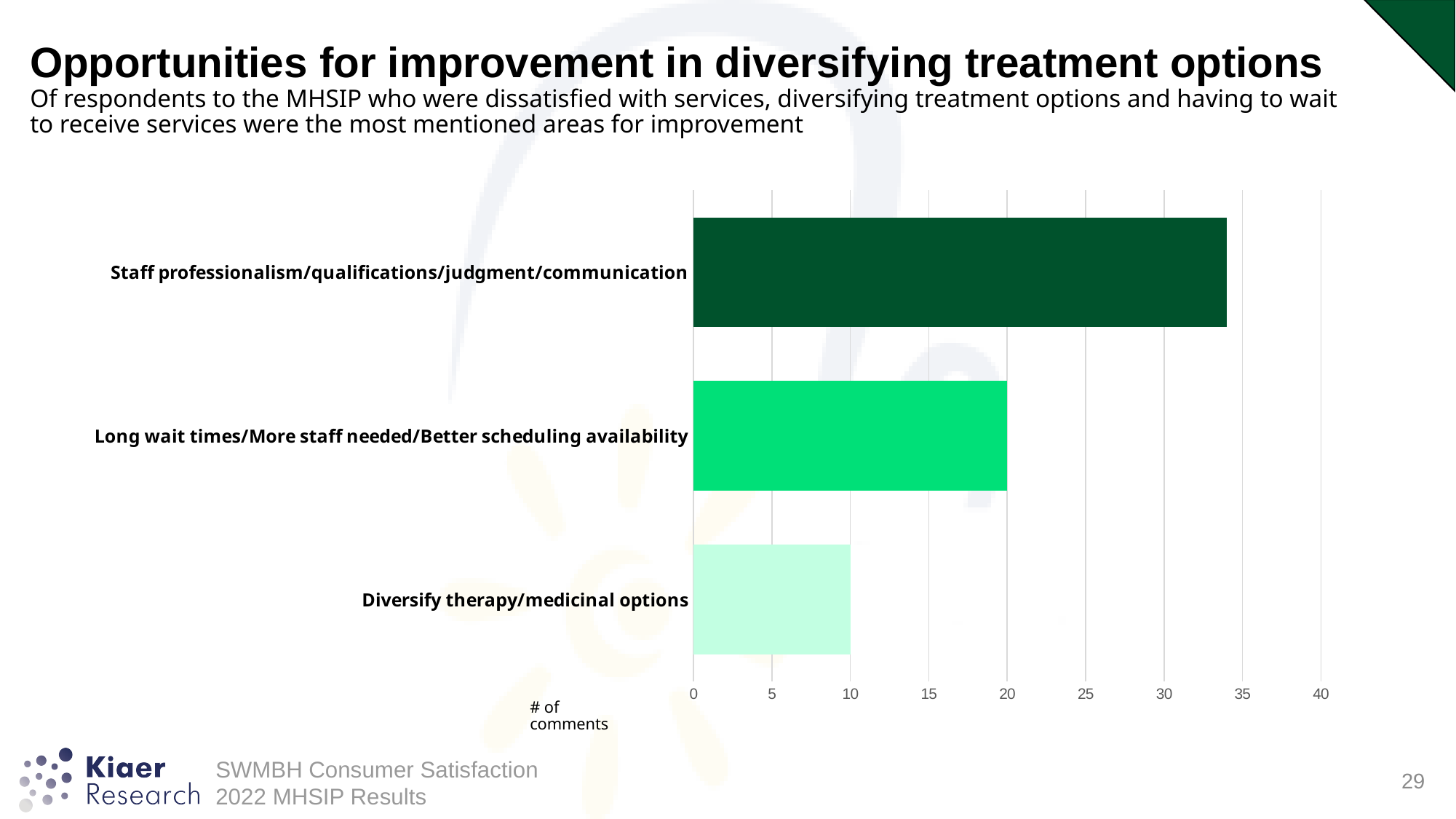
Is the value for Staff professionalism/qualifications/judgment/communication greater or less than 35? less What is the maximum value shown on the horizontal axis? 40 Is the value for Staff professionalism/qualifications/judgment/communication greater or less than 30? greater How many comments are shown for Diversify therapy/medicinal options? 10 Which category has the highest number of comments? Staff professionalism/qualifications/judgment/communication How many categories are plotted in the chart? 3 How many comments are shown for Long wait times/More staff needed/Better scheduling availability? 20 What is the difference in number of comments between Long wait times/More staff needed/Better scheduling availability and Diversify therapy/medicinal options? 10 Which has more comments: Long wait times/More staff needed/Better scheduling availability or Diversify therapy/medicinal options? Long wait times/More staff needed/Better scheduling availability What kind of chart is shown on the slide? bar chart Which category has the lowest number of comments? Diversify therapy/medicinal options What is the label on the horizontal axis of the chart? # of comments